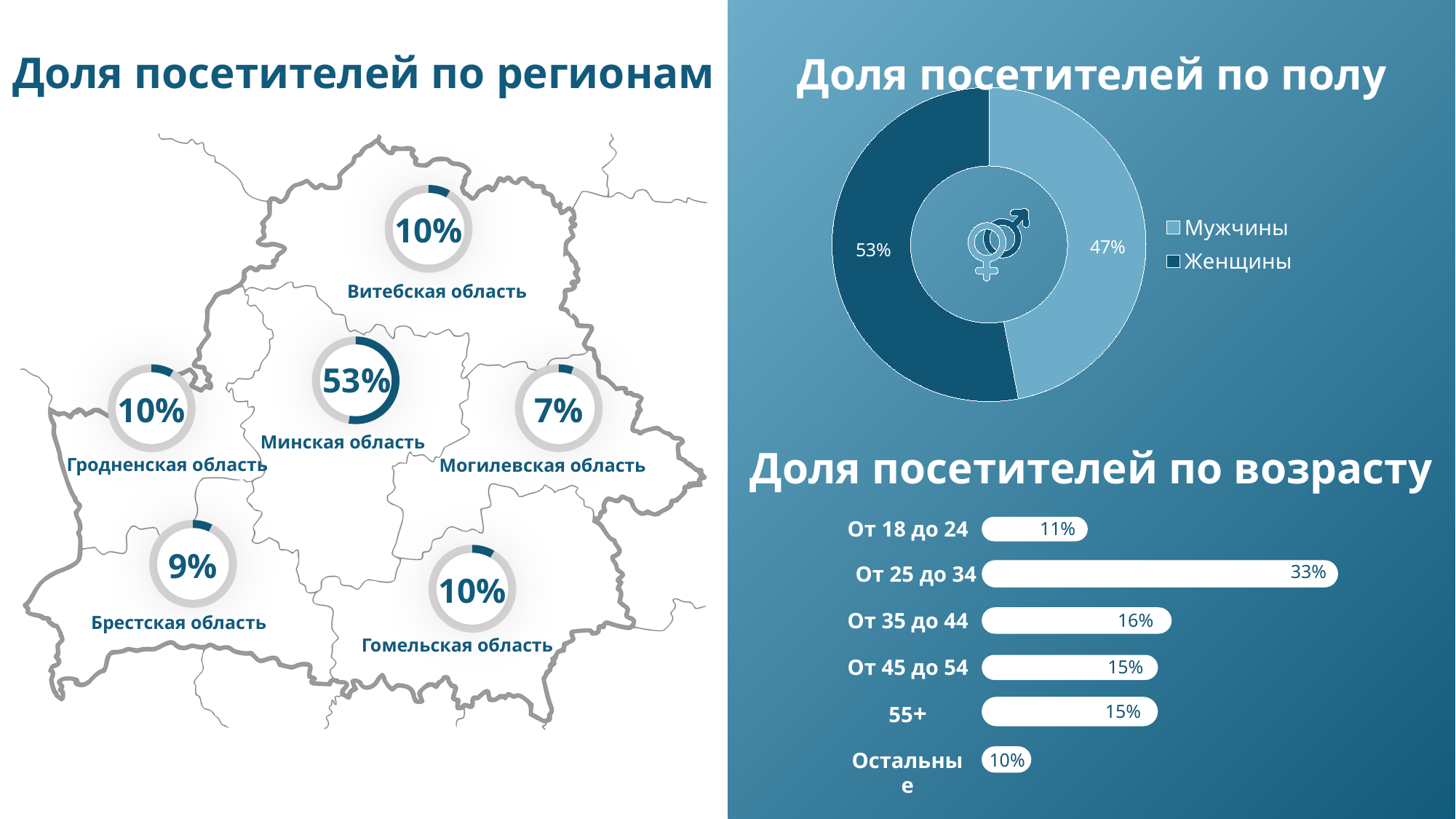
In the chart 'Доля посетителей по полу', what share of visitors are Женщины? 53% What kind of chart is 'Доля посетителей по возрасту'? bar chart In the chart 'Доля посетителей по возрасту', which age group has the highest share? От 25 до 34 In the chart 'Доля посетителей по регионам', what is the share for Минская область? 53% In the chart 'Доля посетителей по возрасту', what is the value for 'От 25 до 34'? 33% In the chart 'Доля посетителей по возрасту', what is the difference between 'От 25 до 34' and 'От 18 до 24'? 22% In the chart 'Доля посетителей по регионам', which region has the lowest share? Могилевская область In the chart 'Доля посетителей по возрасту', which category has the lowest share? Остальные In the chart 'Доля посетителей по возрасту', how many categories are shown? 6 In the chart 'Доля посетителей по полу', what is the difference between the share of Женщины and the share of Мужчины? 6% In the chart 'Доля посетителей по полу', how many series does the legend list? 2 In the chart 'Доля посетителей по полу', what share of visitors are Мужчины? 47%